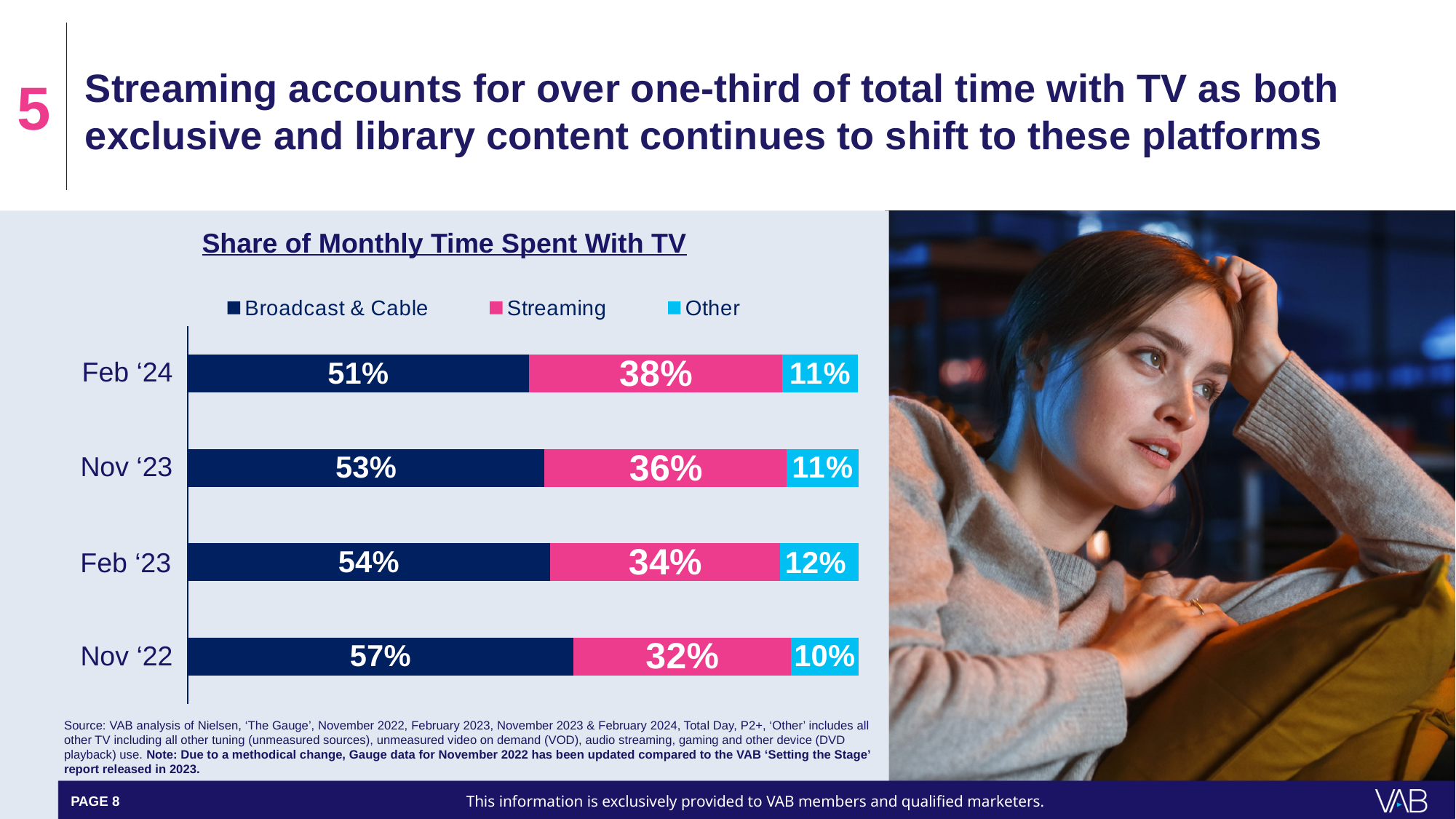
What is the Broadcast & Cable share for Nov '22? 57% How many series does the legend list? 3 Which is larger in Nov '23: the Broadcast & Cable share or the Streaming share? Broadcast & Cable What is the title of the chart? Share of Monthly Time Spent With TV Which period has the highest Streaming share? Feb '24 What is the Other share for Feb '23? 12% Does the Streaming share rise or fall from Nov '22 to Feb '24? Rise What kind of chart is shown on the slide? Stacked bar chart How many time periods are shown on the chart? 4 Which period has the lowest Broadcast & Cable share? Feb '24 What is the difference between the Broadcast & Cable share in Nov '22 and in Feb '24? 6 percentage points What is the Streaming share for Feb '24? 38%